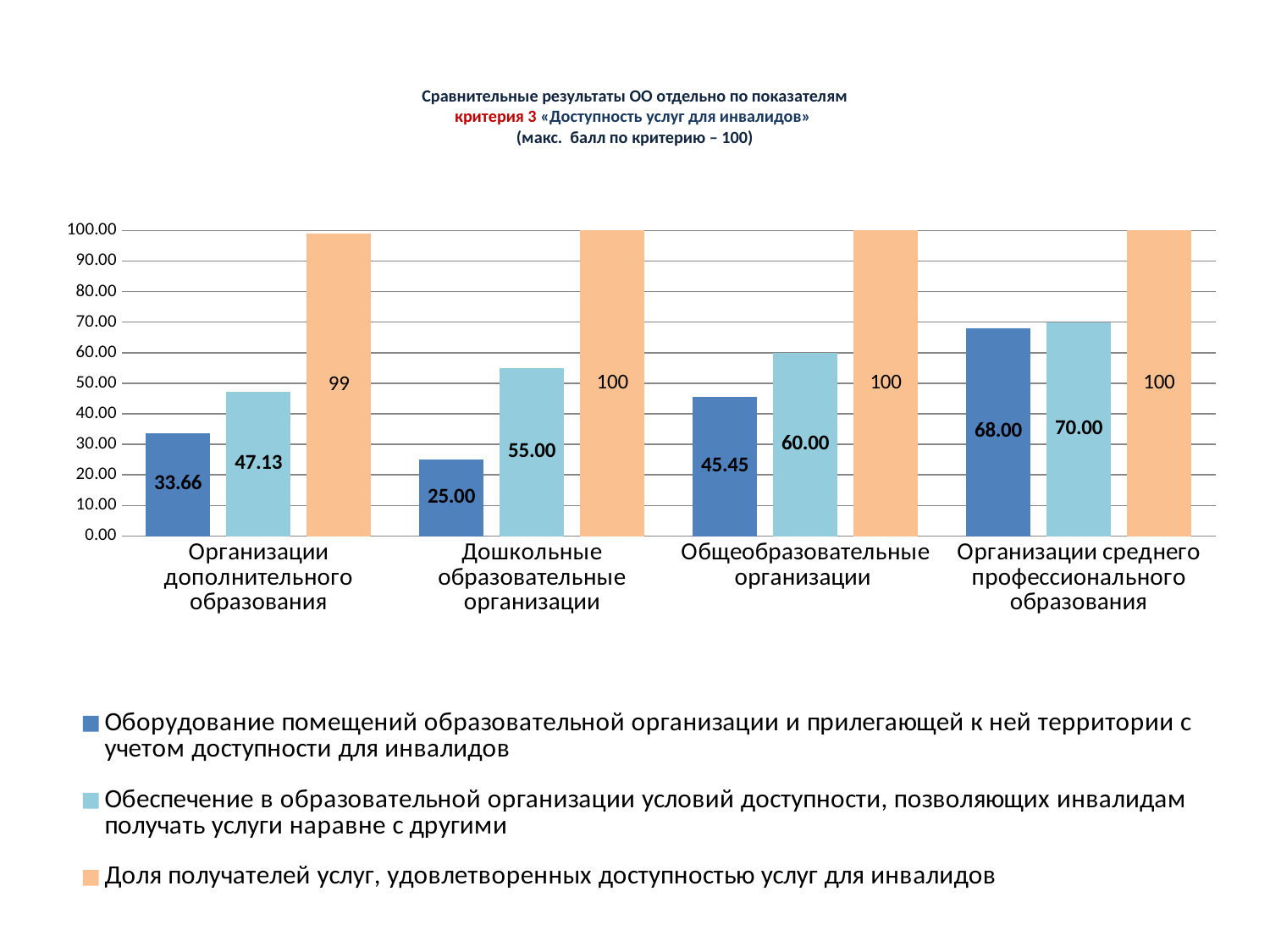
What is the value of «Оборудование помещений образовательной организации и прилегающей к ней территории с учетом доступности для инвалидов» for «Дошкольные образовательные организации»? 25.00 What is the difference between the «Обеспечение в образовательной организации условий доступности...» value and the «Оборудование помещений...» value for «Дошкольные образовательные организации»? 30.00 Is the value of «Оборудование помещений...» for «Организации дополнительного образования» greater or less than 40.00? less What kind of chart is shown on the slide? bar chart What is the value of «Доля получателей услуг, удовлетворенных доступностью услуг для инвалидов» for «Организации дополнительного образования»? 99 How many categories are shown on the x axis of the chart? 4 What is the value of «Обеспечение в образовательной организации условий доступности, позволяющих инвалидам получать услуги наравне с другими» for «Организации дополнительного образования»? 47.13 How many series does the legend list? 3 Which is larger for «Общеобразовательные организации»: the «Оборудование помещений...» value or the «Обеспечение в образовательной организации условий доступности...» value? Обеспечение в образовательной организации условий доступности, позволяющих инвалидам получать услуги наравне с другими What is the maximum score per criterion stated in the chart title? 100 Which category has the lowest value for «Обеспечение в образовательной организации условий доступности, позволяющих инвалидам получать услуги наравне с другими»? Организации дополнительного образования Which category has the highest value for «Оборудование помещений образовательной организации и прилегающей к ней территории с учетом доступности для инвалидов»? Организации среднего профессионального образования